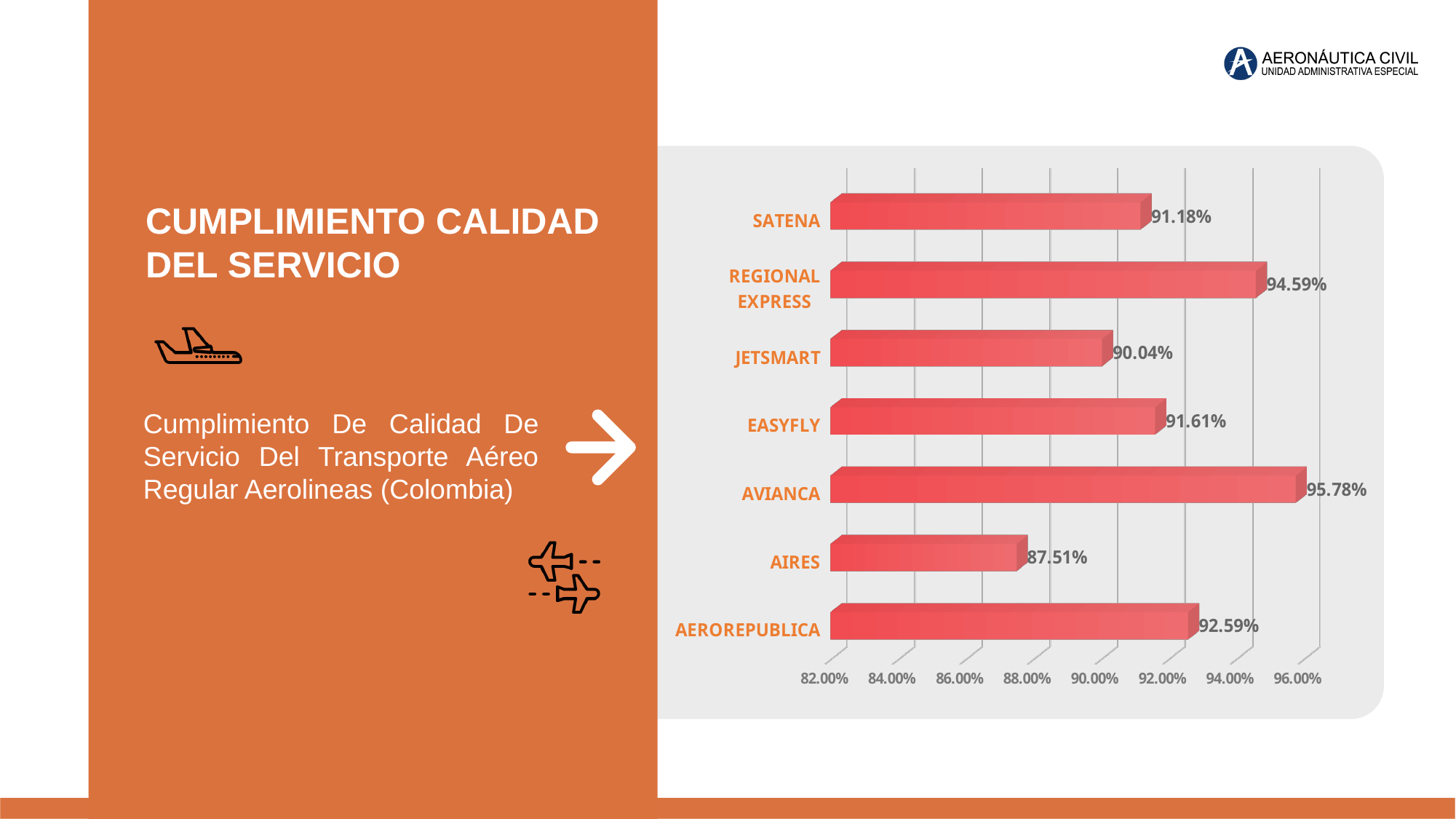
What is the difference between the values for AVIANCA and AIRES? 8.27% What is the value for AVIANCA? 95.78% What kind of chart is shown on the slide? bar chart What is the value for AIRES? 87.51% Is the value for AEROREPUBLICA greater or less than 92.00%? greater What is the value for JETSMART? 90.04% Which airline has the highest value? AVIANCA Which is larger, the value for SATENA or the value for EASYFLY? EASYFLY What is the value for REGIONAL EXPRESS? 94.59% Which airline has the lowest value? AIRES What is the difference between the values for REGIONAL EXPRESS and JETSMART? 4.55% How many airlines are shown in the chart? 7